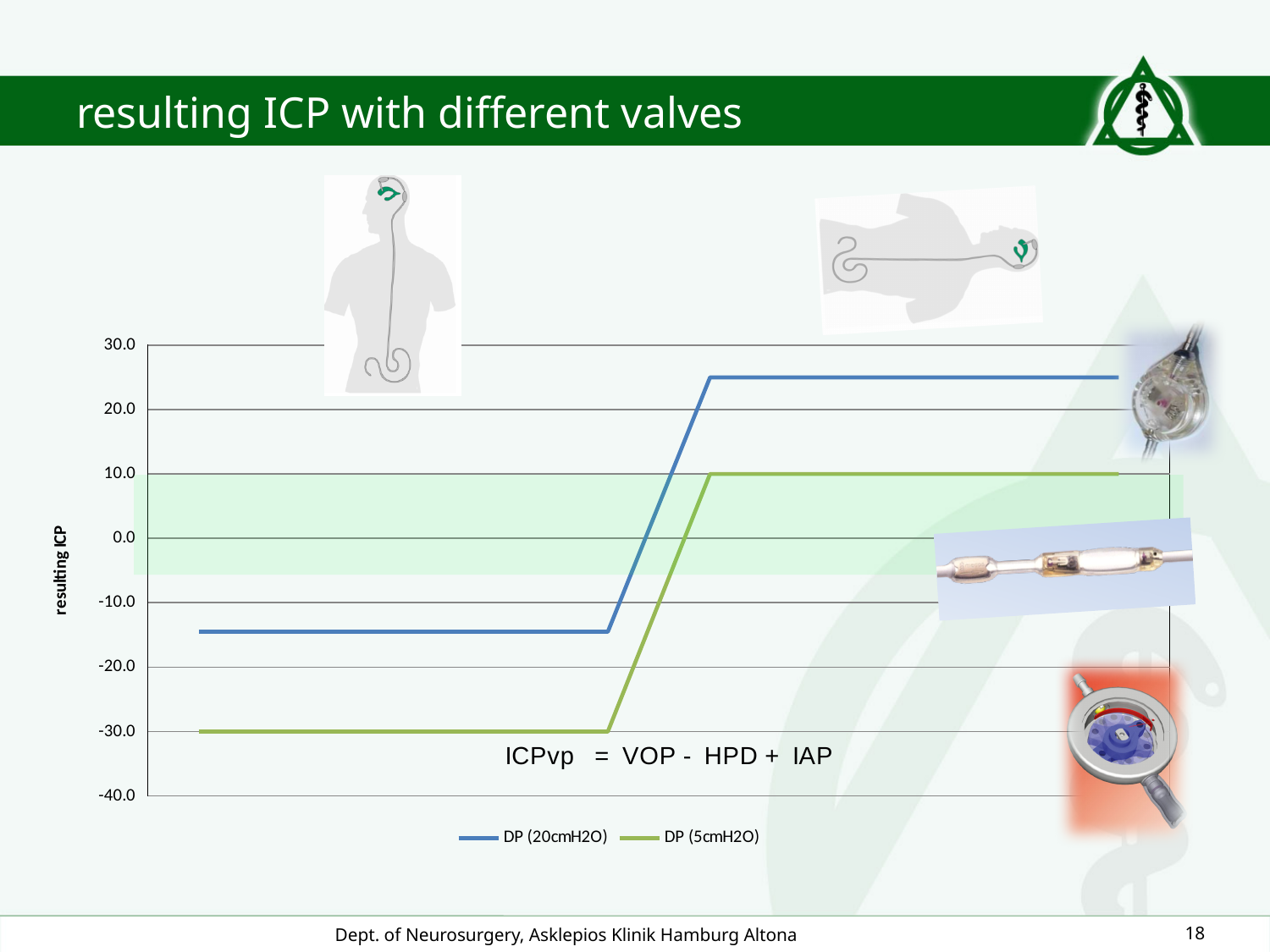
Do the lines rise or fall moving from left to right along the x axis? rise Which series reaches the higher value on the right side of the chart, DP (20cmH2O) or DP (5cmH2O)? DP (20cmH2O) Is the left-hand plateau of the DP (20cmH2O) line greater or less than -10.0? less Which series has the lowest value on the chart? DP (5cmH2O) What kind of chart is shown on the slide? line chart What are the two series named in the chart legend? DP (20cmH2O) and DP (5cmH2O) Is the right-hand plateau of the DP (20cmH2O) line greater or less than 20.0? greater How many series does the chart legend list? 2 By how much does the DP (5cmH2O) line increase from its left plateau to its right plateau? 40.0 What is the label on the vertical axis of the chart? resulting ICP At what value does the DP (5cmH2O) line start on the left side of the chart? -30.0 At what value does the DP (5cmH2O) line level off on the right side of the chart? 10.0